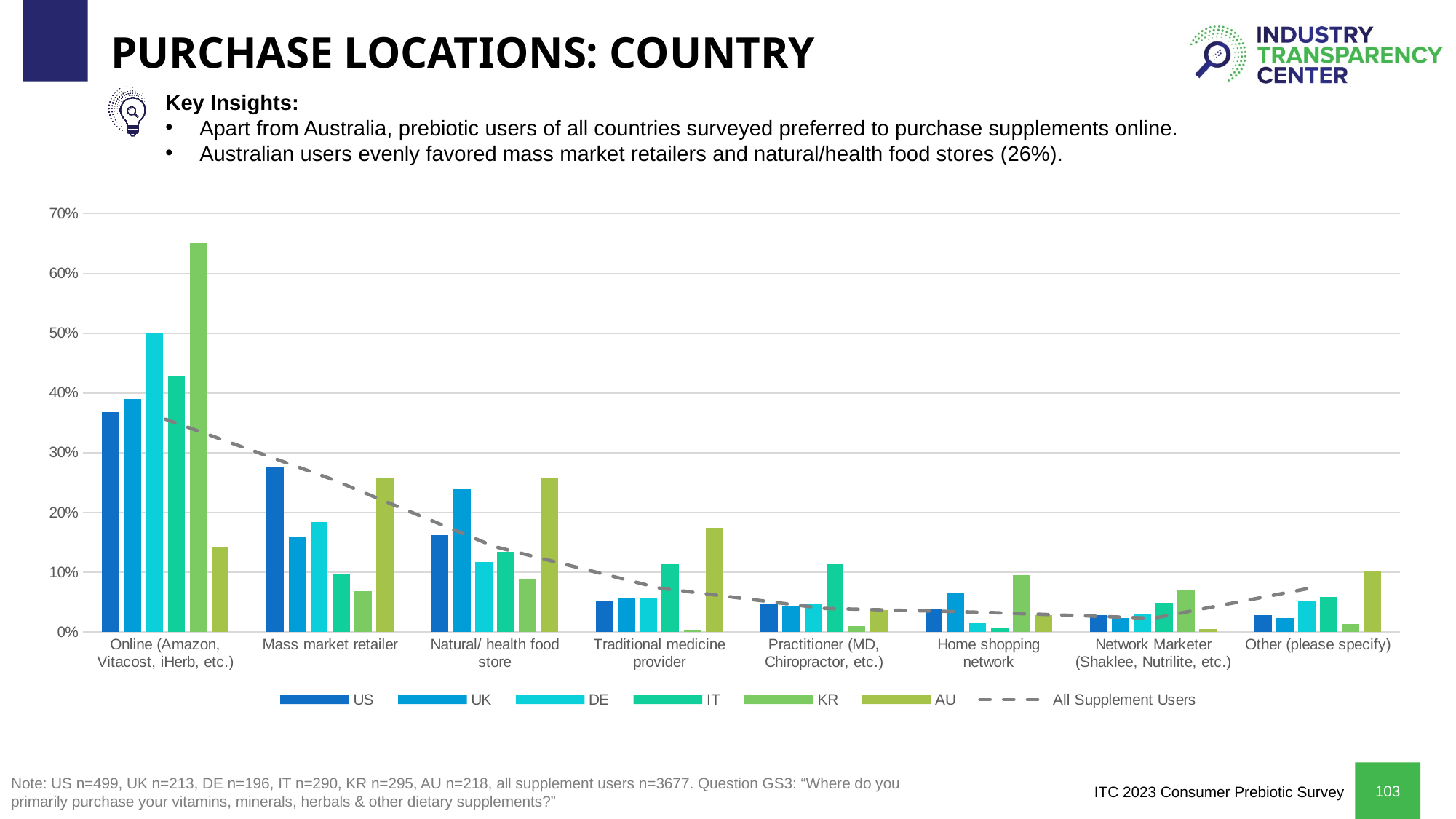
Is the US value for Online (Amazon, Vitacost, iHerb, etc.) greater or less than 30%? greater How many purchase location categories are shown on the x axis? 8 Which country has the lowest bar for Online (Amazon, Vitacost, iHerb, etc.)? AU What kind of chart is shown on the slide? combination bar and line chart Which country has the highest bar for Online (Amazon, Vitacost, iHerb, etc.)? KR Which legend entry is drawn as a dashed line rather than a bar? All Supplement Users Is the AU value for Mass market retailer greater or less than 20%? greater Is the KR value for Online (Amazon, Vitacost, iHerb, etc.) greater or less than 60%? greater For Mass market retailer, which is larger, the US bar or the UK bar? US How many entries does the legend list? 7 Which country has the highest bar for Traditional medicine provider? AU Which country has the highest bar for Home shopping network? KR